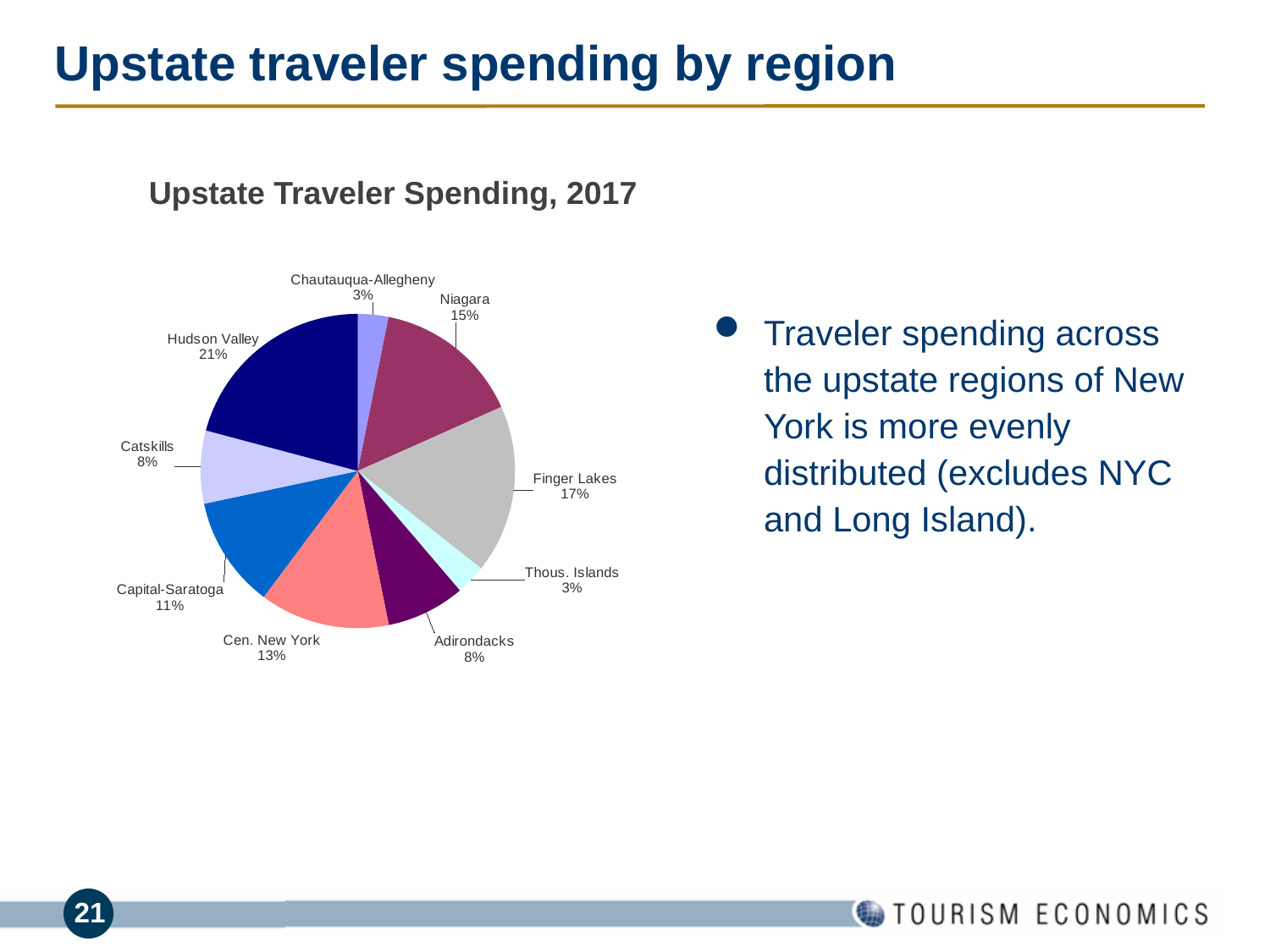
What percentage is shown for Capital-Saratoga? 11% What is the difference in percentage points between Hudson Valley and Niagara? 6 What share of upstate traveler spending does Hudson Valley account for? 21% Which regions are tied for the smallest share of spending? Chautauqua-Allegheny and Thous. Islands What is the combined share of Catskills and Adirondacks? 16% Which region has the largest share of upstate traveler spending? Hudson Valley What type of chart is shown on the slide? Pie chart What is the value shown for Finger Lakes? 17% How many regions are shown in the pie chart? 9 Which has a larger share, Finger Lakes or Cen. New York? Finger Lakes What share of spending does Niagara represent? 15% What is the title of the chart? Upstate Traveler Spending, 2017